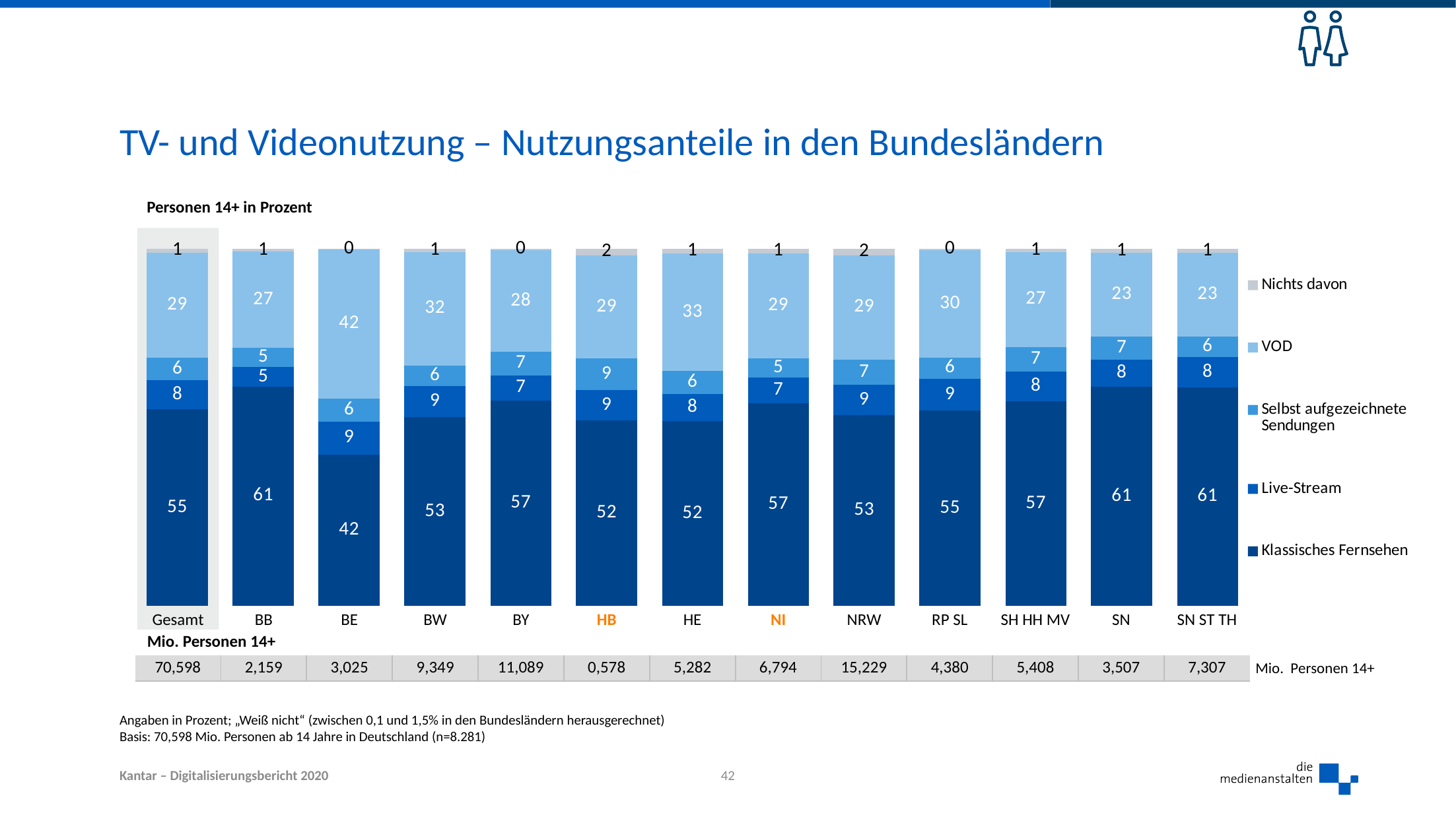
How many categories are shown on the x axis? 13 Which has the larger VOD value, BW or SN? BW What is the total of the stacked bar for HE? 100 What is the Live-Stream value for Gesamt? 8 How many series does the legend list? 5 Which category has the highest VOD value? BE What is the Klassisches Fernsehen value for BE? 42 What is the VOD value for HE? 33 What kind of chart is shown on the slide? Stacked bar chart Which category has the lowest Klassisches Fernsehen value? BE What is the difference between the Klassisches Fernsehen values for BB and BW? 8 What is the Nichts davon value for HB? 2